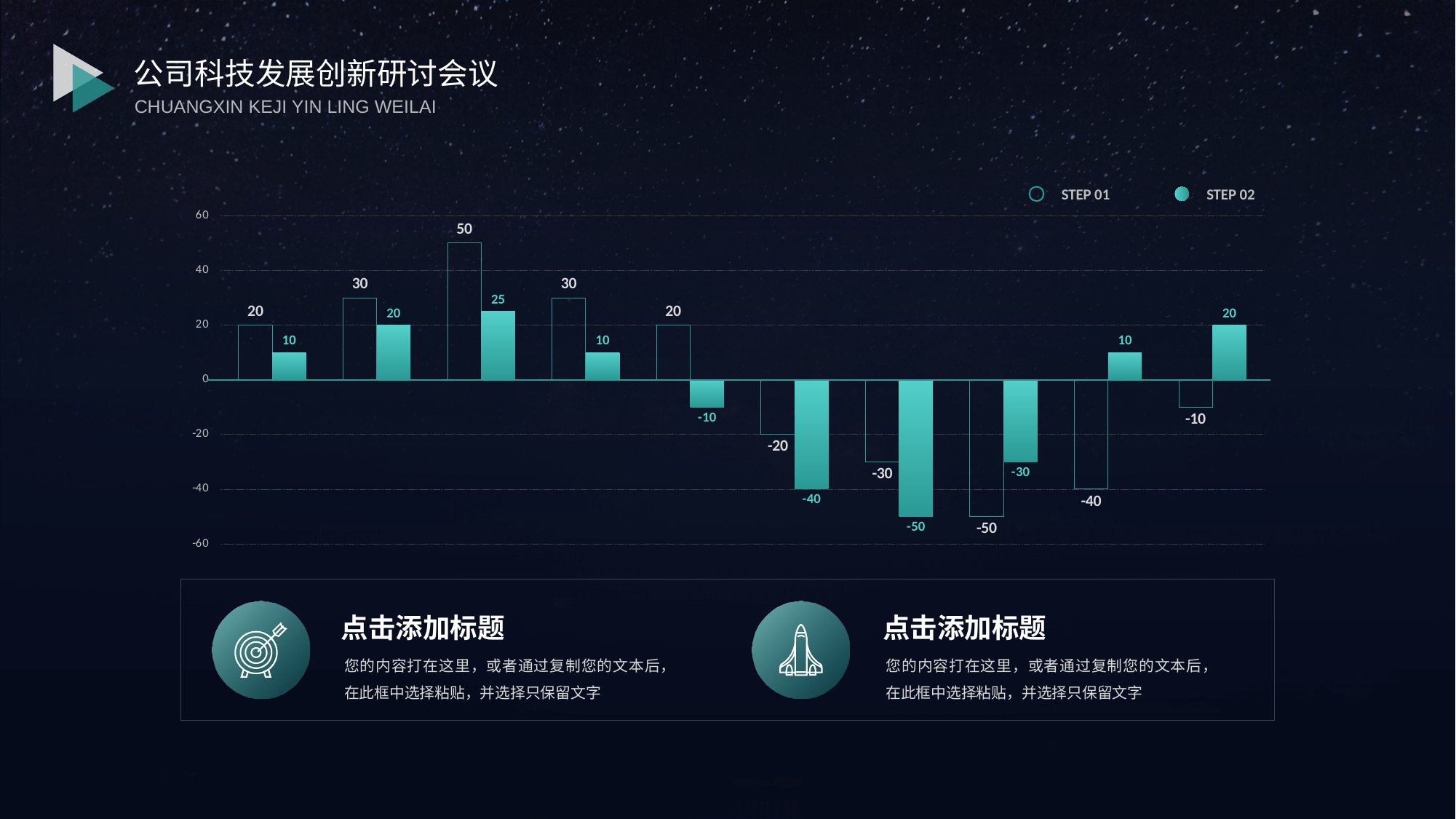
What is the difference between the third STEP 01 bar (50) and the third STEP 02 bar (25)? 25 How many bars are plotted for the STEP 01 series? 10 What are the names of the two series in the chart legend? STEP 01 and STEP 02 How many series does the chart legend list? 2 What is the value of the last STEP 02 bar (rightmost filled bar)? 20 What is the lowest value in the STEP 01 series? -50 What is the value of the third STEP 02 bar, next to the STEP 01 bar labelled 50? 25 What is the value of the first STEP 02 bar (leftmost filled bar)? 10 What type of chart is shown on the slide? bar chart Which is larger: the STEP 01 bar labelled -20 or the STEP 02 bar labelled -40 next to it? STEP 01 (-20) What is the lowest value in the STEP 02 series? -50 What is the highest value in the STEP 01 series? 50